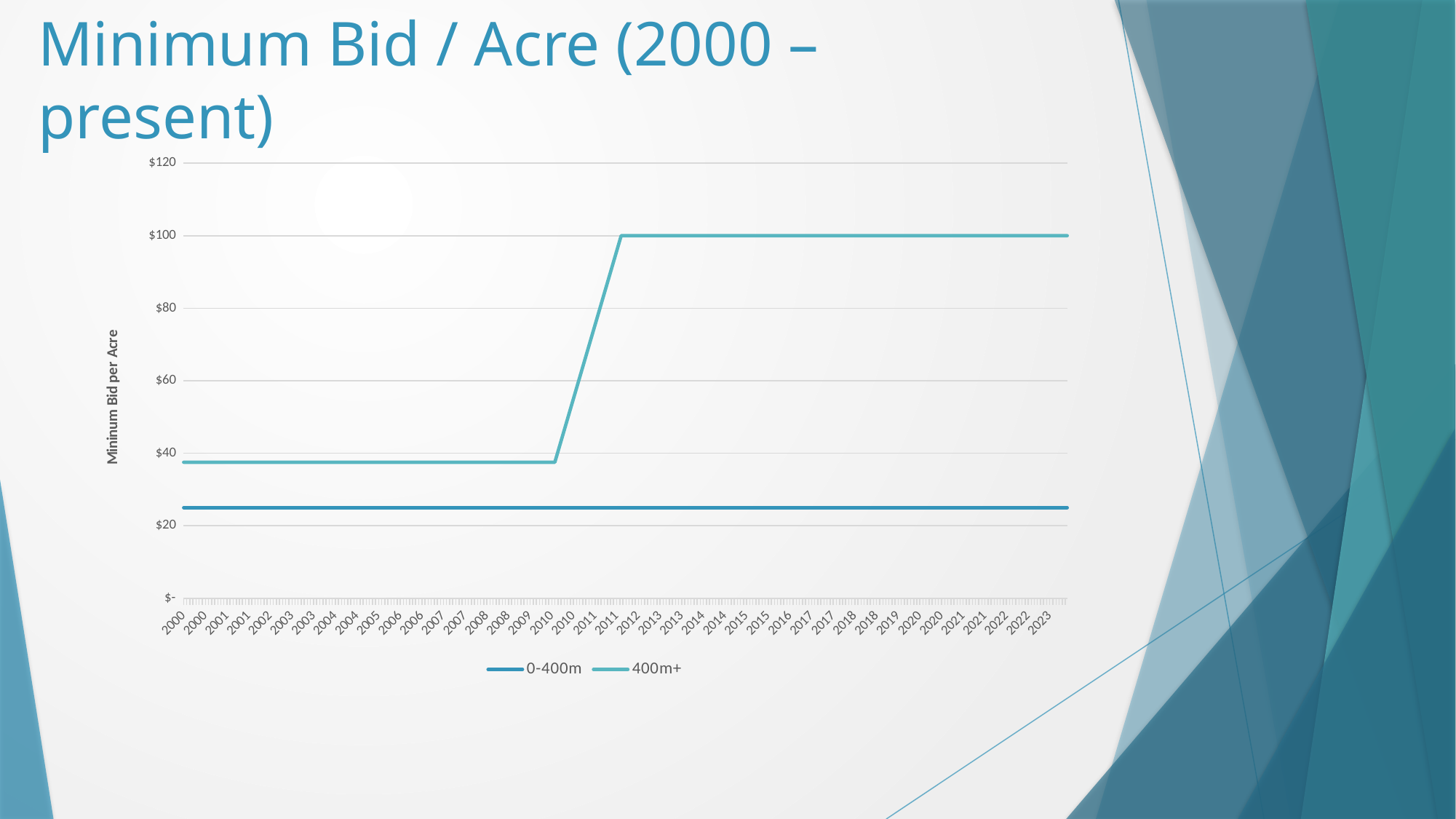
What kind of chart is shown on the slide? line chart Is the value of the 400m+ series in 2005 greater or less than $20? greater Does the 400m+ series rise or fall between 2010 and 2012? rise What is the value of the 400m+ series in 2015? $100 Is the value of the 0-400m series in 2005 greater or less than $40? less What is the label on the vertical axis? Mininum Bid per Acre What are the two series named in the legend? 0-400m and 400m+ What is the value of the 400m+ series in 2020? $100 Which series has the higher value in 2022, 0-400m or 400m+? 400m+ Is the value of the 0-400m series in 2018 greater or less than $20? greater How many series does the legend list? 2